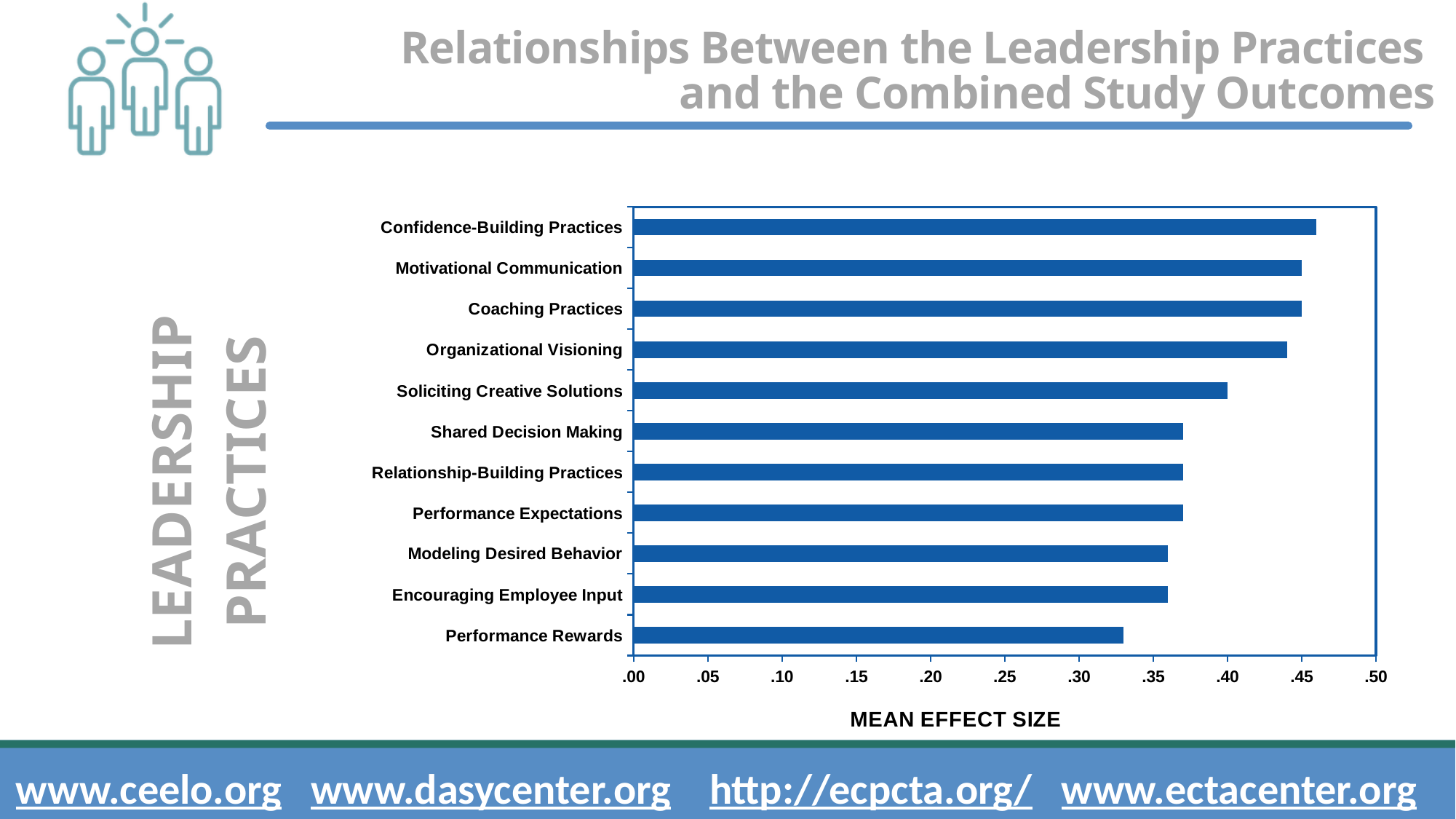
Which leadership practice has the highest mean effect size? Confidence-Building Practices How many leadership practices are plotted in the chart? 11 Which has a larger mean effect size, Organizational Visioning or Soliciting Creative Solutions? Organizational Visioning Is the mean effect size for Confidence-Building Practices greater or less than .45? greater What kind of chart is shown on the slide? bar chart Is the mean effect size for Shared Decision Making greater or less than .40? less Reading the bars from top to bottom, do the mean effect sizes get larger or smaller? smaller Is the mean effect size for Organizational Visioning greater or less than .40? greater What is the mean effect size for Soliciting Creative Solutions? .40 What is the title of the horizontal axis of the chart? MEAN EFFECT SIZE Which leadership practice has the lowest mean effect size? Performance Rewards